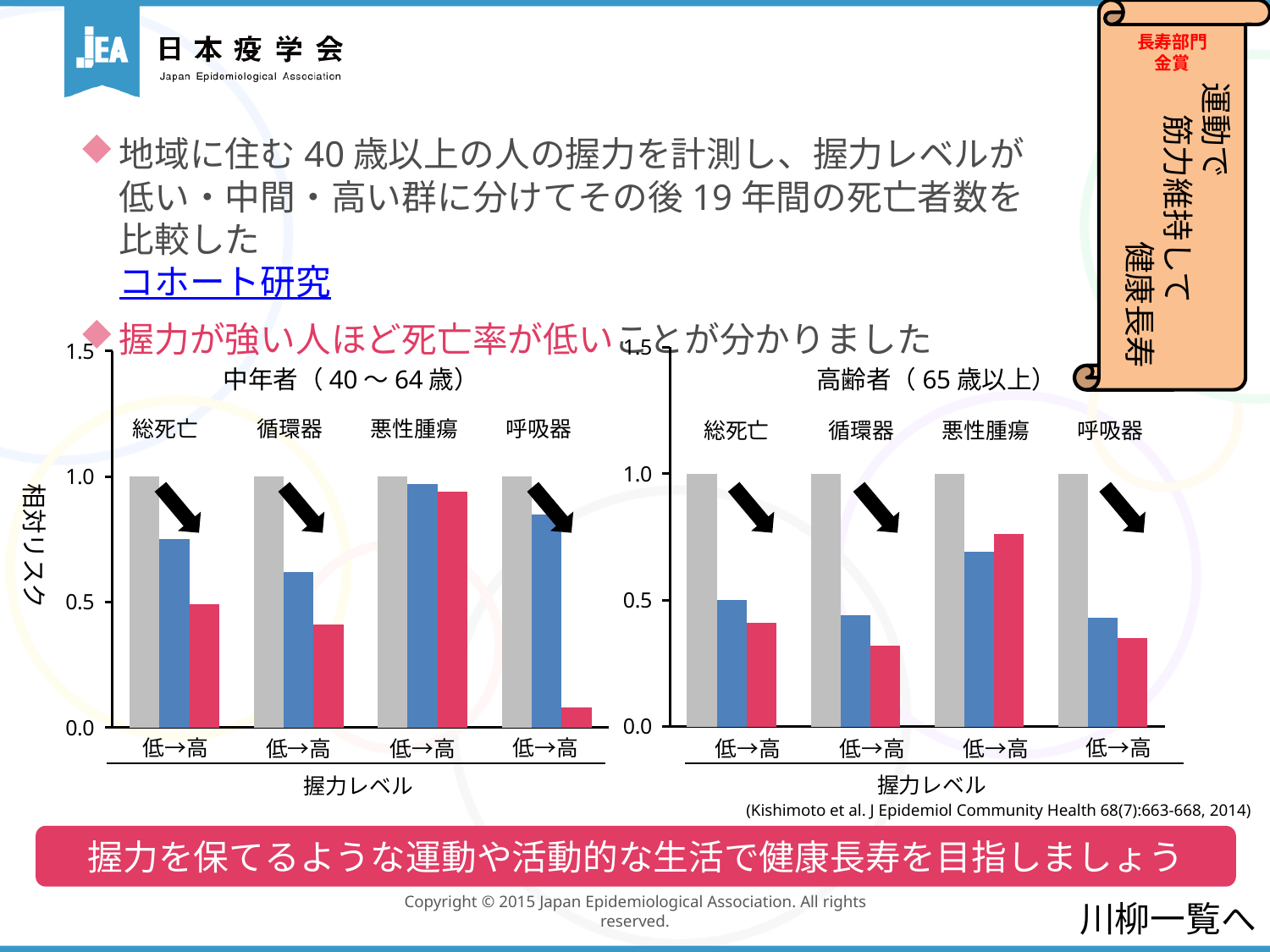
On the right chart (高齢者), is the red (high grip strength) bar for 循環器 greater or less than 0.5? less On the right chart (高齢者), is the blue (middle grip strength) bar for 悪性腫瘍 greater or less than 0.5? greater On the left chart (中年者), do the bars for 総死亡 rise or fall going from low to high grip strength (低→高)? fall On the left chart (中年者), what is the relative risk value of the gray (low grip strength) bar for 総死亡? 1.0 On the left chart (中年者), is the blue (middle grip strength) bar for 循環器 greater or less than 0.5? greater What kind of chart is the left chart (中年者 40～64歳)? bar chart What is the label on the vertical axis of the left chart? 相対リスク How many cause-of-death categories are shown on the right chart (高齢者 65歳以上)? 4 What is the title of the right chart? 高齢者（65歳以上） On the left chart (中年者), which is larger for 呼吸器: the blue bar or the red bar? the blue bar On the left chart (中年者), which bar is the lowest of all the bars? the red bar for 呼吸器